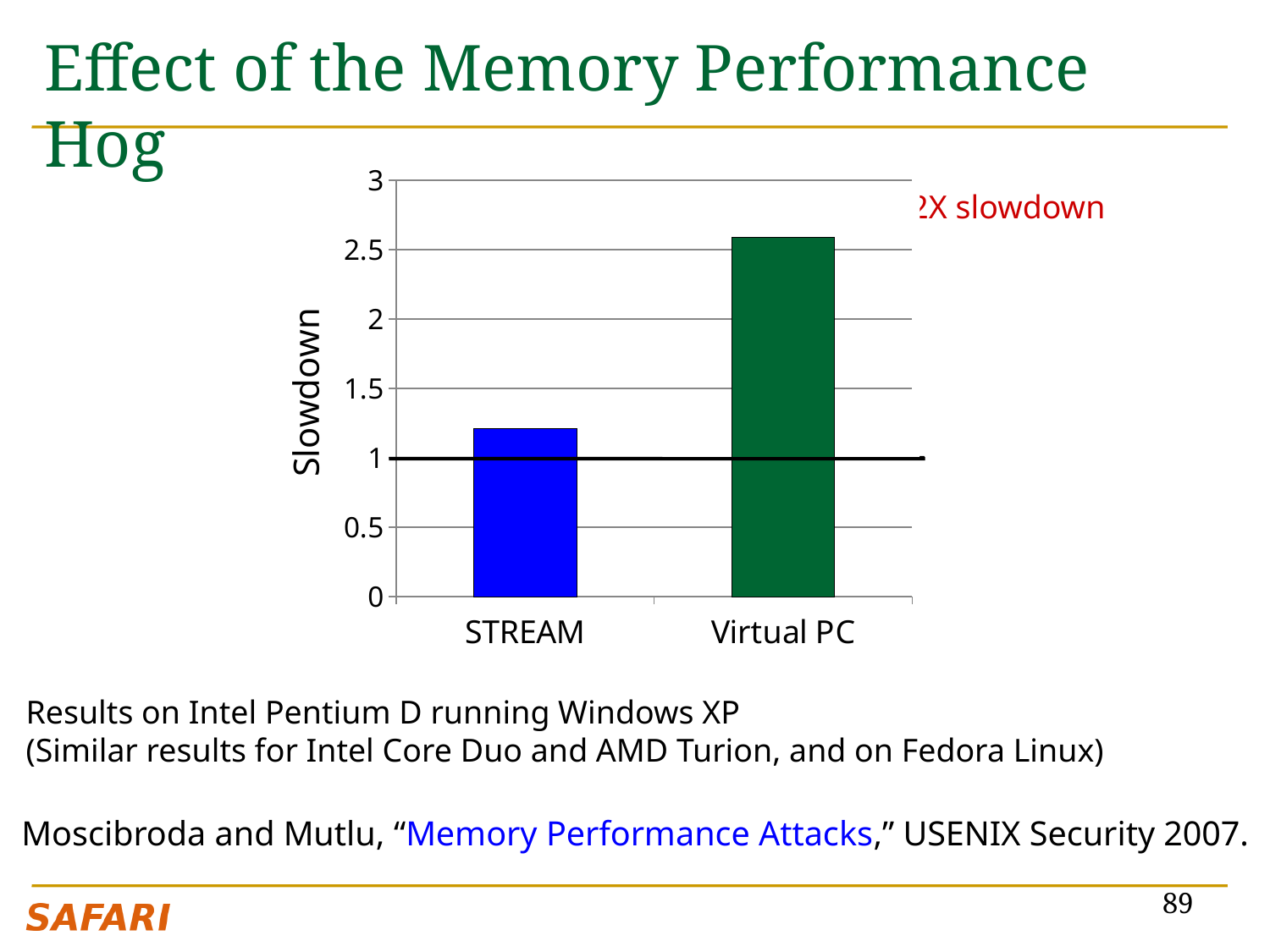
Which has a larger slowdown, STREAM or Virtual PC? Virtual PC Which category has the lowest slowdown? STREAM What is the label on the y axis of the chart? Slowdown Is the slowdown for STREAM greater or less than 1.5? less What kind of chart is shown on the slide? bar chart How many categories are plotted on the x axis? 2 Which category has the highest slowdown? Virtual PC What is the maximum value shown on the y axis? 3 Is the slowdown for STREAM greater or less than 1? greater Is the slowdown for Virtual PC greater or less than 2? greater